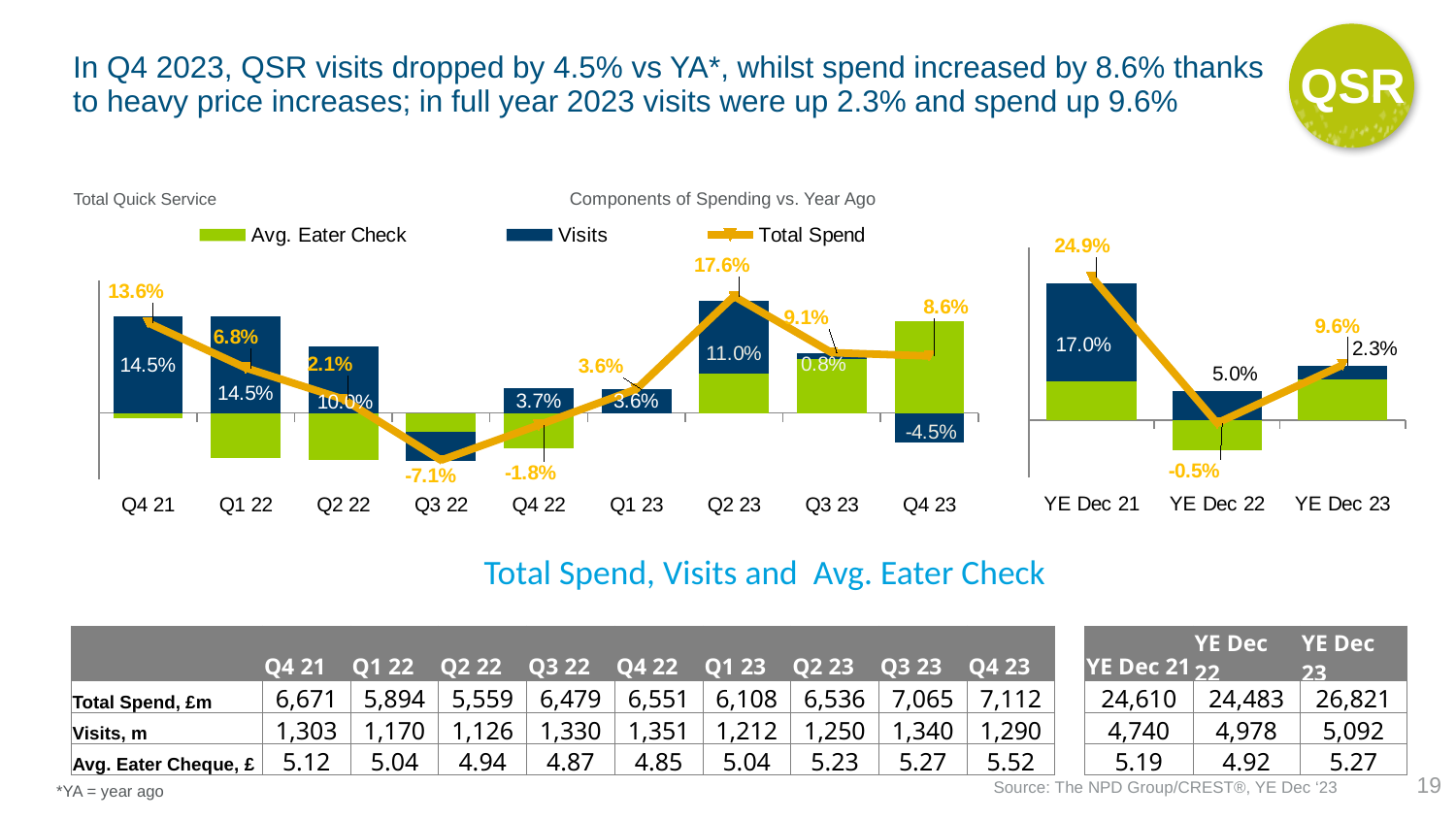
In the quarterly chart, which quarter has the highest Total Spend value? Q2 23 In the quarterly chart, which is larger: the Visits value for Q4 21 or for Q2 22? Q4 21 In the quarterly chart, which quarter has the lowest Total Spend value? Q3 22 In the quarterly chart, what is the Visits value for Q4 23? -4.5% How many quarters are shown on the x axis of the quarterly chart? 9 In the quarterly chart, what is the difference between the Total Spend values for Q2 23 and Q3 23? 8.5 percentage points In the yearly chart, what is the Visits value for YE Dec 21? 17.0% What kind of chart is used for the quarterly data? Bar chart with a line How many series does the legend list? 3 In the yearly chart (YE Dec 21 to YE Dec 23), what is the Total Spend value for YE Dec 23? 9.6% In the quarterly chart (Q4 21 to Q4 23), what is the Total Spend value for Q2 23? 17.6% In the yearly chart, which year has the lowest Total Spend value? YE Dec 22